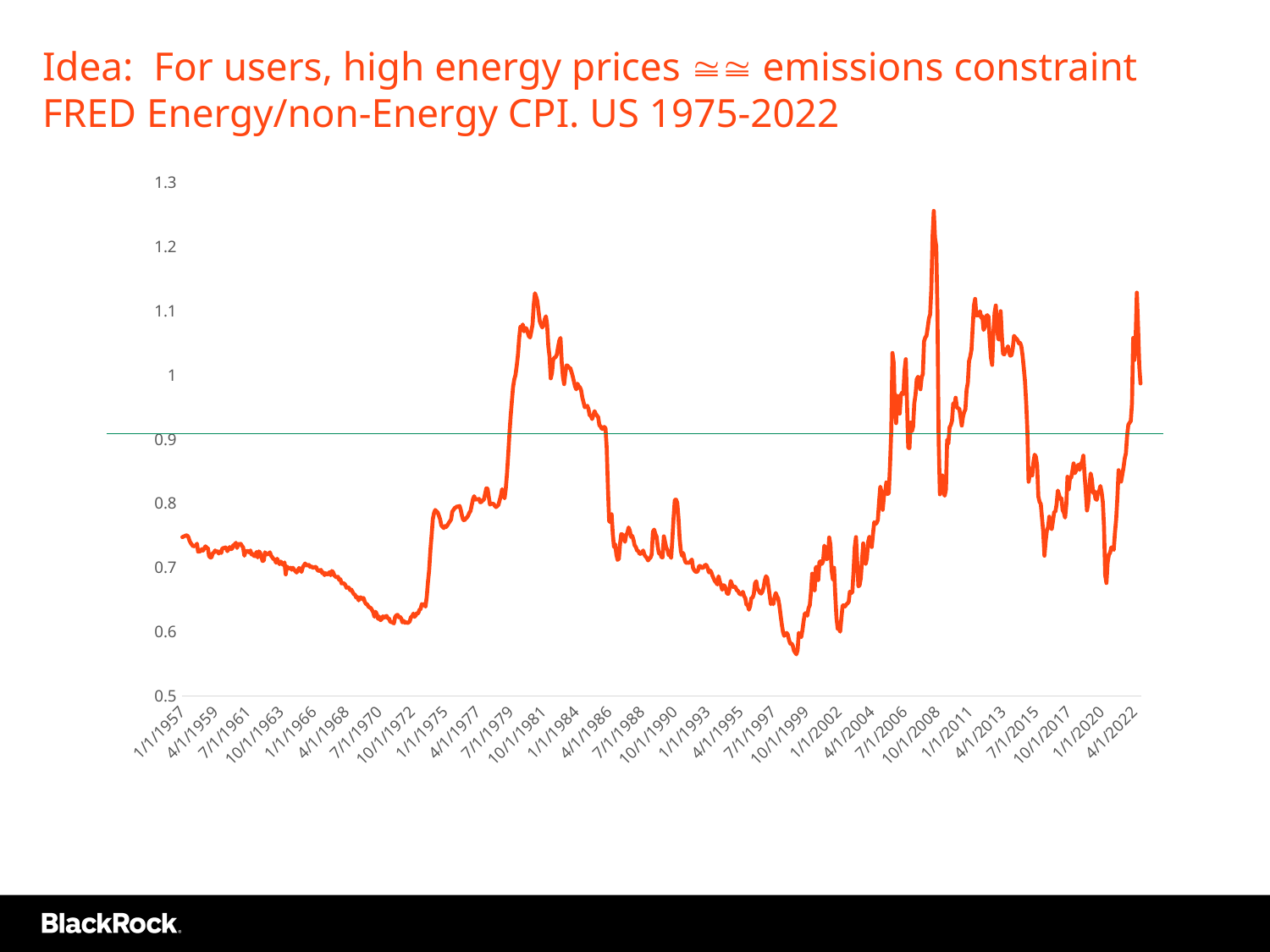
What kind of chart is shown on the slide? line chart What colour is the plotted data line? orange Does the line rise or fall between 1/1/1957 and 7/1/1970? fall Is the value at 1/1/1957 greater or less than 0.7? greater Is the lowest value around 10/1/1999 greater or less than 0.6? less Around which x-axis date does the line reach its highest value? 10/1/2008 Around which x-axis date does the line reach its lowest value? 10/1/1999 Is the value around 7/1/1970 greater or less than 0.7? less What is the title of the chart on the slide? FRED Energy/non-Energy CPI. US 1975-2022